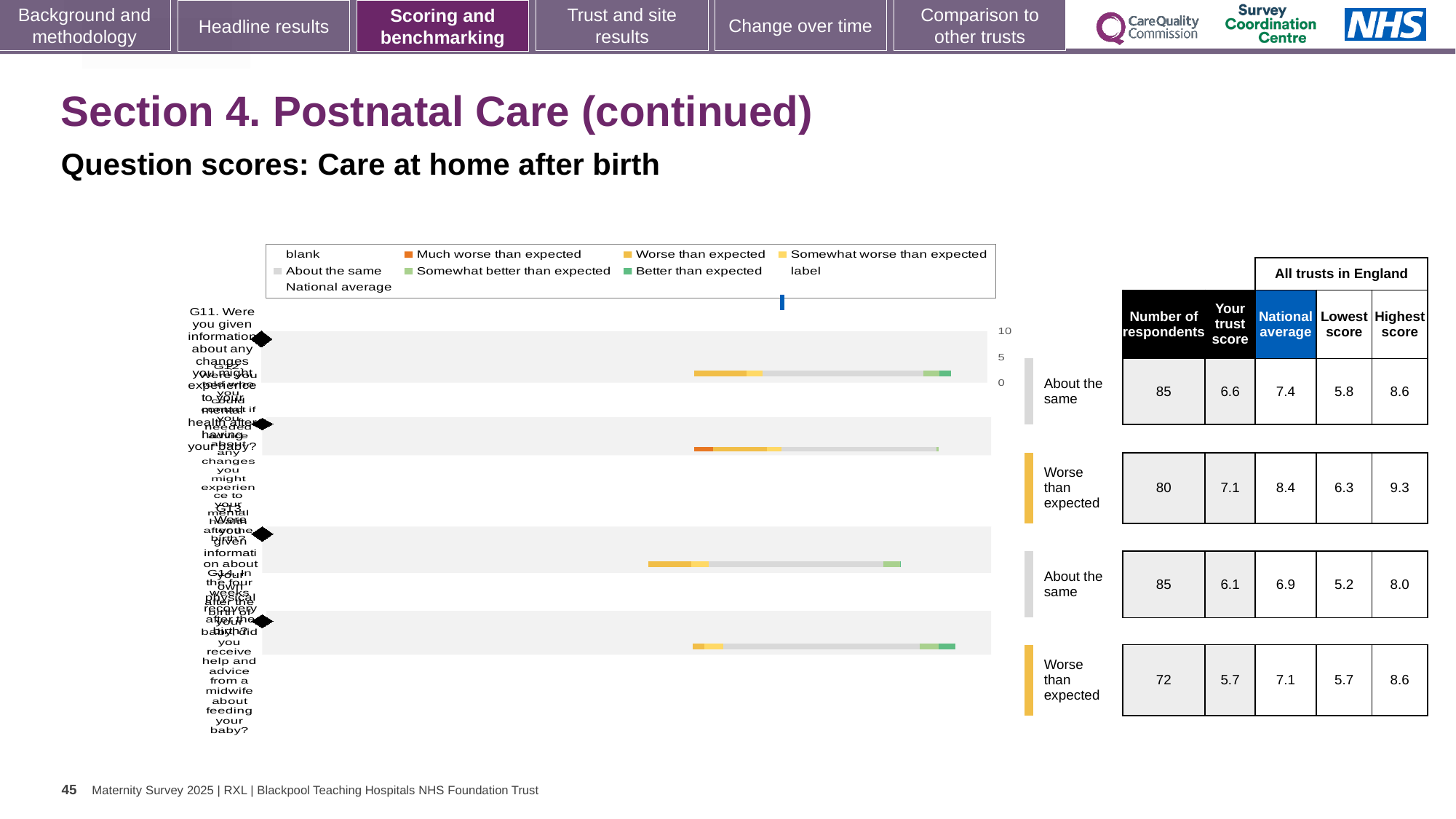
Which question row has the highest 'Your trust score' in the table? the second row (7.1) What is the highest score among all trusts in England for the third question row? 8.0 Which question row has the lowest 'Your trust score' in the table? the fourth row (5.7) In the chart legend, what colour is used for 'Much worse than expected'? orange In the chart legend, what colour is used for 'Better than expected'? green What is the number of respondents for the fourth (bottom) question row? 72 What is the 'Your trust score' for the first (top) question row in the table beside the chart? 6.6 Is the trust score for the first question row larger or smaller than its national average? smaller What is the difference between the national average and the trust score for the second question row? 1.3 What is the national average for the second question row in the table beside the chart? 8.4 How many question rows (bars) are plotted in the chart? 4 What kind of chart is shown on the slide? bar chart